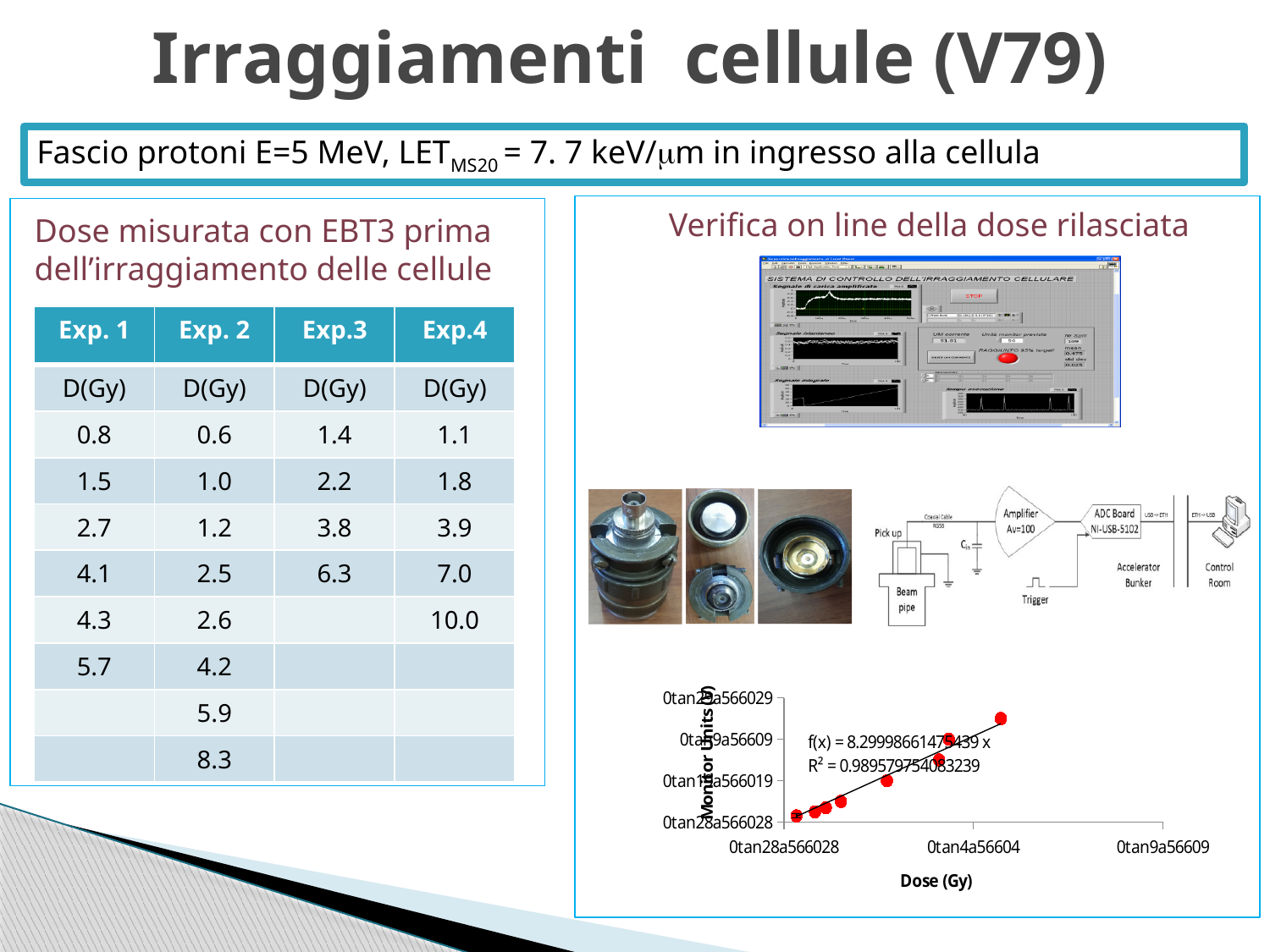
What kind of chart is shown at the bottom right of the slide (Monitor Units vs Dose)? scatter chart What R² value is printed on the bottom-right chart? R² = 0.989579754083239 In the bottom-right chart, do the Monitor Units values rise or fall as Dose (Gy) increases? rise What is the title of the vertical axis of the bottom-right chart? Monitor Units What is the title of the horizontal axis of the bottom-right chart? Dose (Gy)